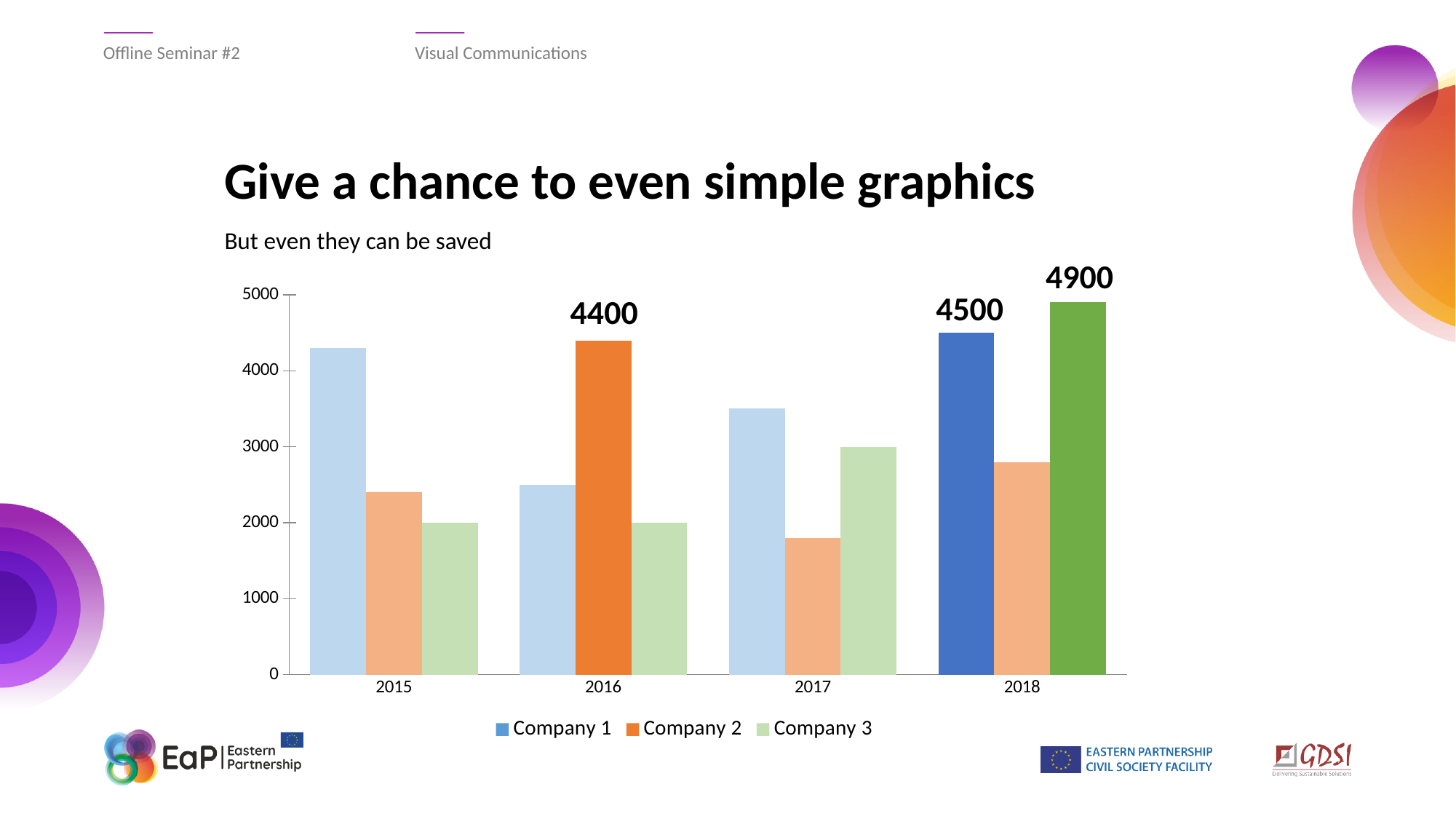
What is the value for Company 3 in 2018? 4900 How many series does the legend list? 3 In which year does Company 3 have its highest value? 2018 Is the value for Company 1 in 2015 greater or less than 4000? greater How many years are shown on the x axis? 4 What is the value for Company 1 in 2018? 4500 What is the difference between the Company 3 and Company 1 values in 2018? 400 What is the value for Company 2 in 2016? 4400 Is the value for Company 1 in 2017 greater or less than 3000? greater In 2018, which is larger: the value for Company 1 or the value for Company 3? Company 3 Is the value for Company 2 in 2017 greater or less than 2000? less What kind of chart is shown on the slide? bar chart